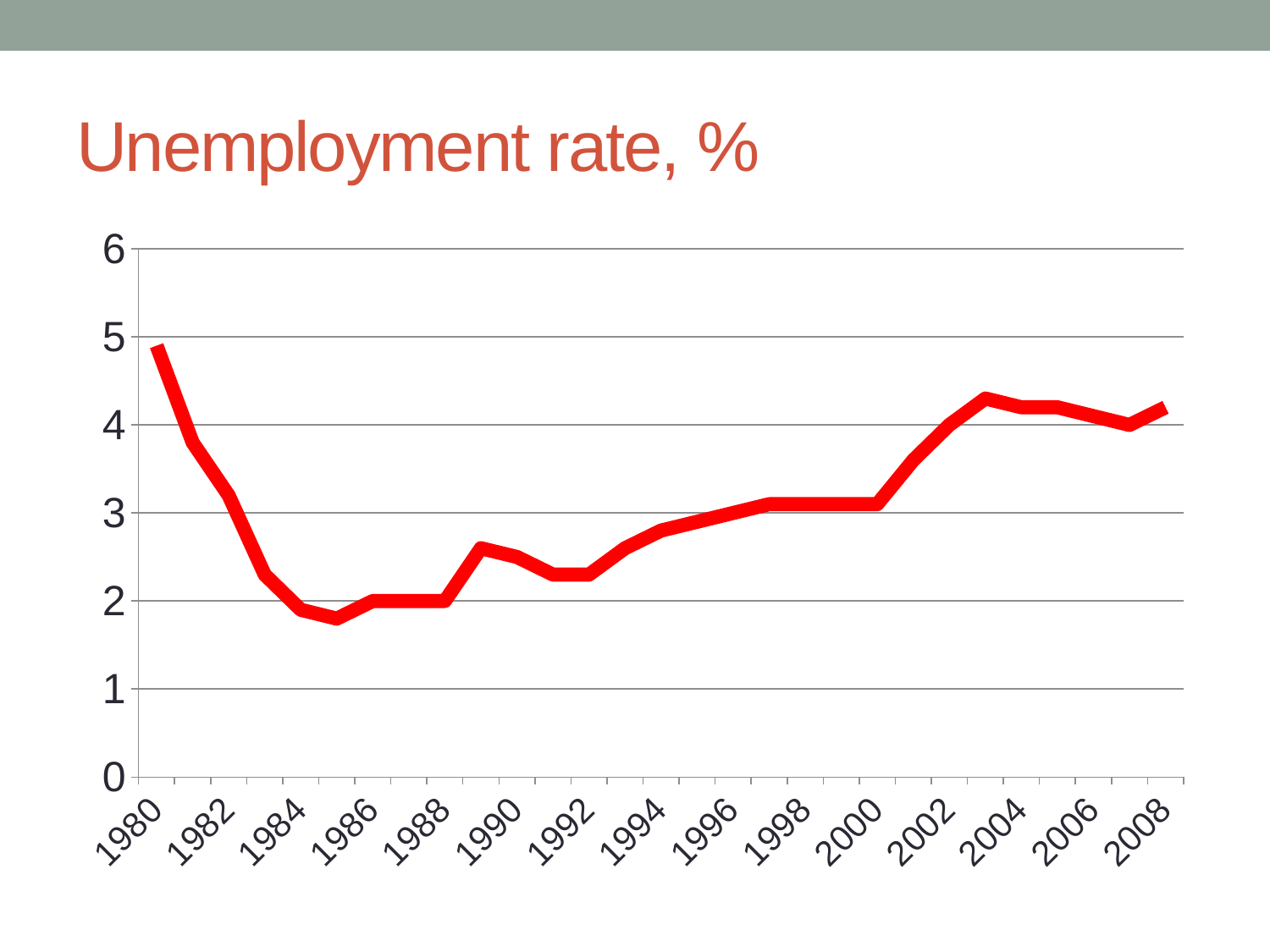
Which year has the larger unemployment rate, 1984 or 2004? 2004 Does the unemployment rate rise or fall between 1980 and 1985? fall Which year has the larger unemployment rate, 1980 or 2008? 1980 Is the value for 1985 greater or less than 2? less Is the value for 1992 greater or less than 3? less What kind of chart is shown on the slide? line chart In which year is the unemployment rate highest? 1980 What is the title of the chart? Unemployment rate, % Does the unemployment rate rise or fall between 1992 and 2003? rise Is the value for 1990 greater or less than 2? greater